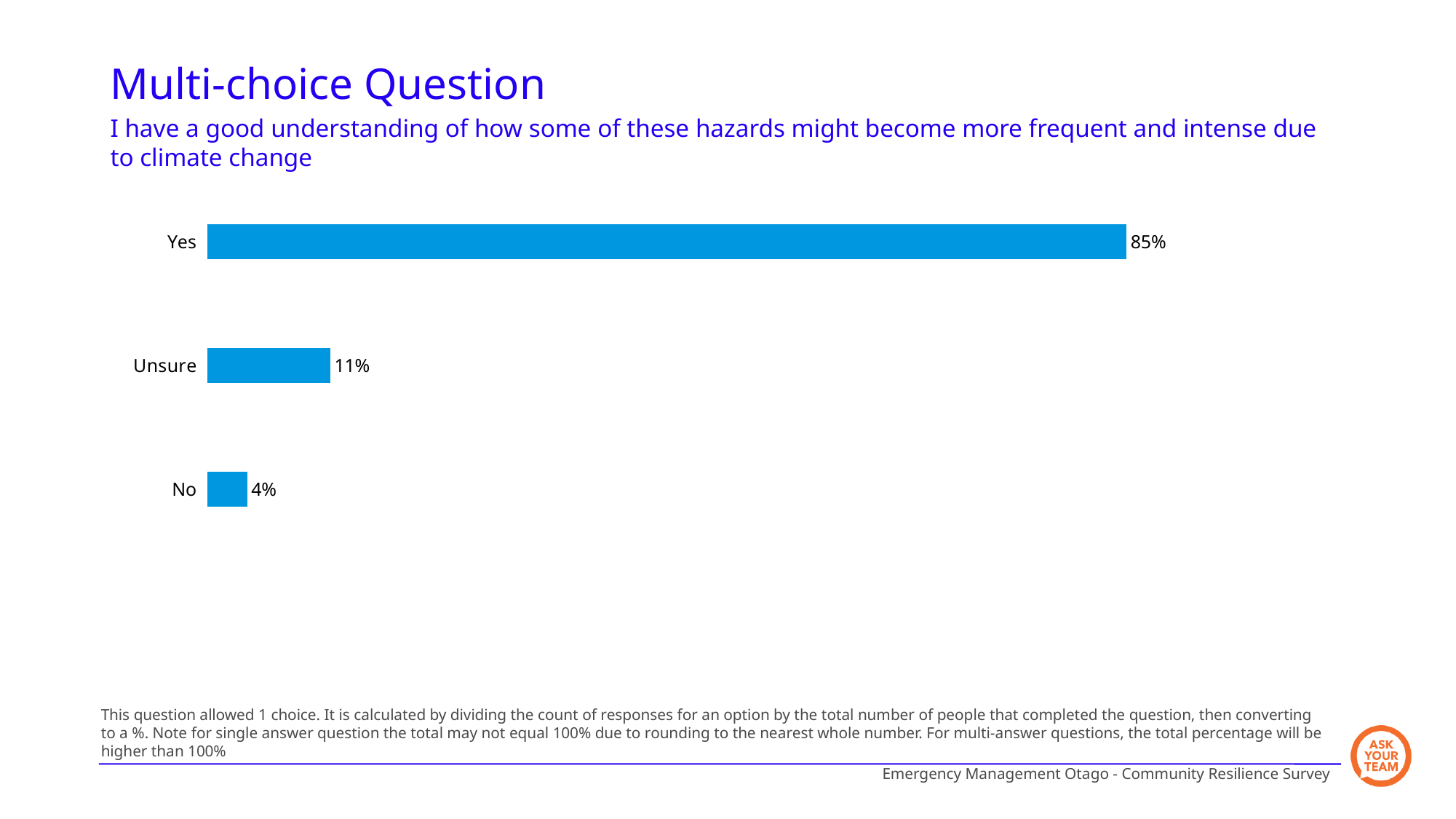
How many response options are shown in the chart? 3 What is the difference in percentage points between Unsure and No? 7 What percentage of respondents answered Yes? 85% Which response option has the lowest percentage? No What type of chart is shown on the slide? Bar chart What is the difference in percentage points between Yes and Unsure? 74 Which response option has the highest percentage? Yes What colour are the bars in the chart? Blue Which is larger, the percentage for Unsure or the percentage for No? Unsure What percentage of respondents answered No? 4% What percentage of respondents answered Unsure? 11% What is the combined percentage of Yes, Unsure and No responses? 100%